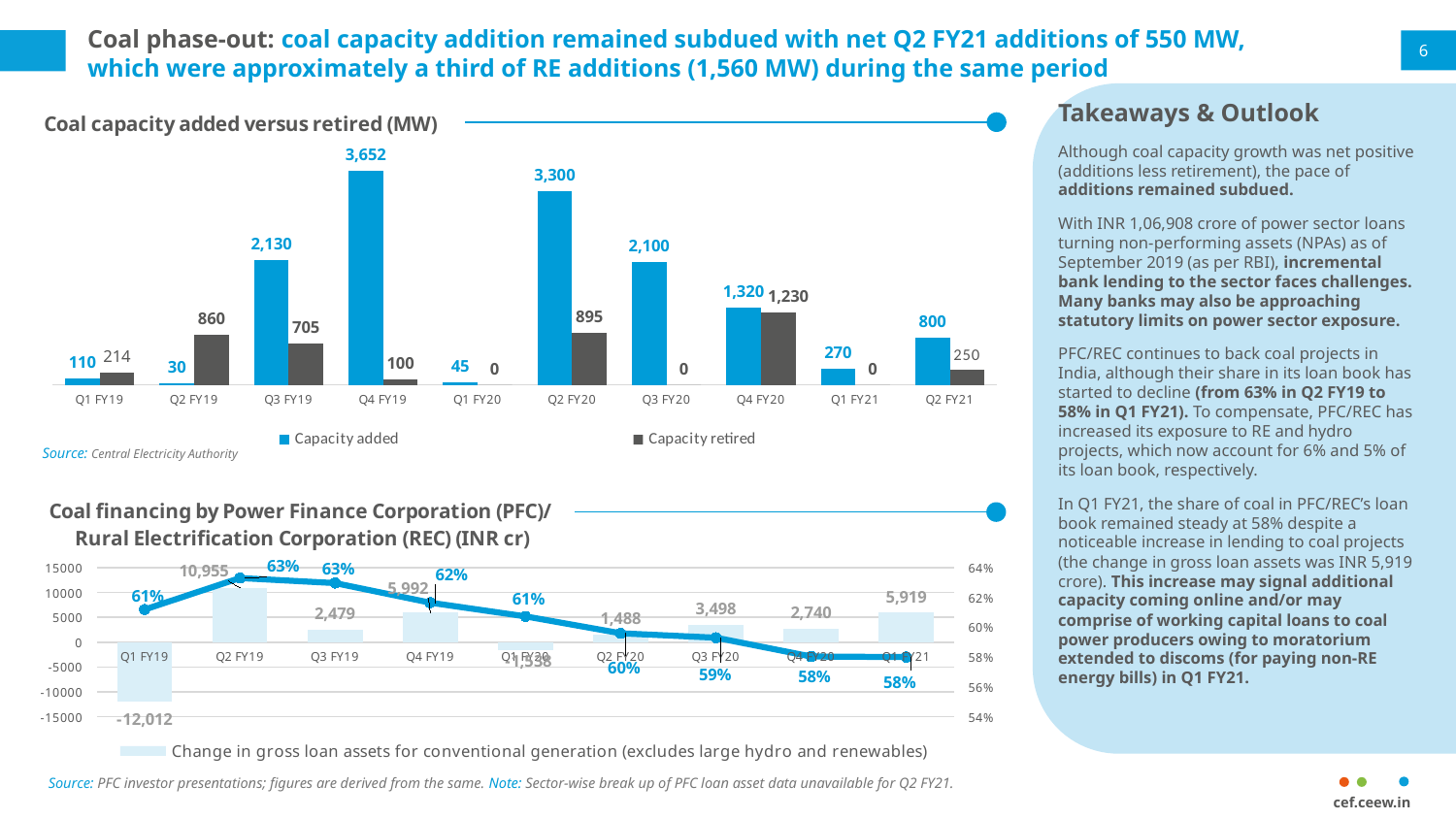
What type of chart is 'Coal capacity added versus retired (MW)'? Bar chart In the 'Coal capacity added versus retired (MW)' chart, what was the capacity added in Q4 FY19? 3,652 In the 'Coal capacity added versus retired (MW)' chart, what is the difference between capacity added and capacity retired in Q2 FY21? 550 In the 'Coal capacity added versus retired (MW)' chart, which quarter had the lowest capacity added? Q2 FY19 In the 'Coal capacity added versus retired (MW)' chart, was more capacity added or retired in Q1 FY19? Retired In the 'Coal capacity added versus retired (MW)' chart, which quarter had the highest capacity added? Q4 FY19 How many series does the legend of the 'Coal capacity added versus retired (MW)' chart list? 2 How many quarters are shown on the x axis of the 'Coal capacity added versus retired (MW)' chart? 10 In the 'Coal financing by PFC/REC (INR cr)' chart, what percentage is shown on the line for Q1 FY21? 58% In the 'Coal financing by PFC/REC (INR cr)' chart, what was the change in gross loan assets for conventional generation in Q1 FY19? -12,012 In the 'Coal financing by PFC/REC (INR cr)' chart, does the percentage line rise or fall from Q3 FY19 to Q1 FY21? Fall In the 'Coal capacity added versus retired (MW)' chart, what was the capacity retired in Q2 FY19? 860